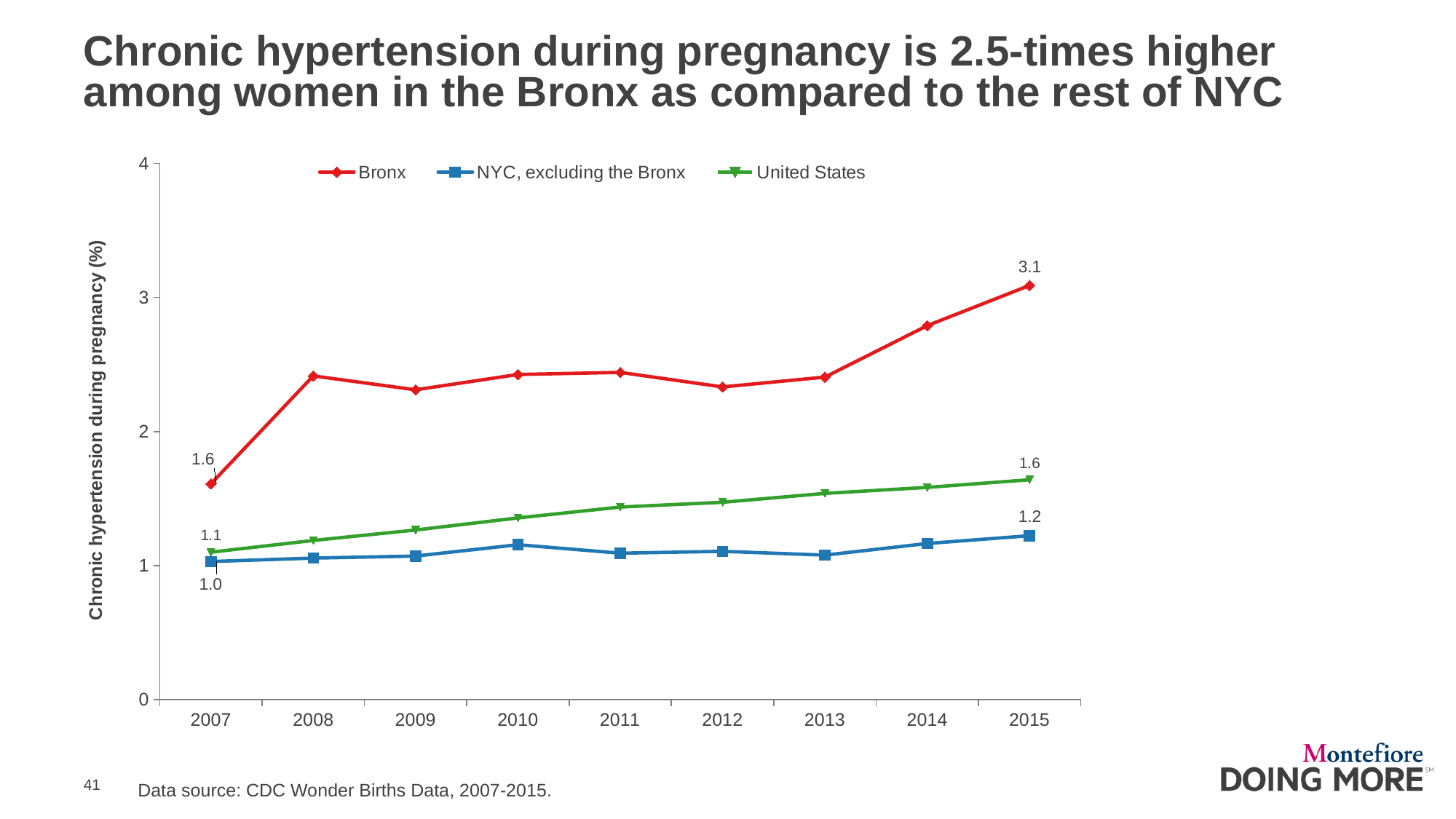
Which series has the highest value in 2015? Bronx By how much did the Bronx value increase from 2007 to 2015? 1.5 How many series does the legend list? 3 In 2015, what is the difference between the Bronx value and the value for NYC, excluding the Bronx? 1.9 Does the United States series rise or fall from 2007 to 2015? Rises What is the Bronx value in 2007? 1.6 How many years are plotted along the x axis? 9 What kind of chart is shown on the slide? Line chart What is the Bronx value in 2015? 3.1 What is the United States value in 2015? 1.6 What is the value for NYC, excluding the Bronx in 2007? 1.0 Is the Bronx value in 2011 greater or less than 2? greater